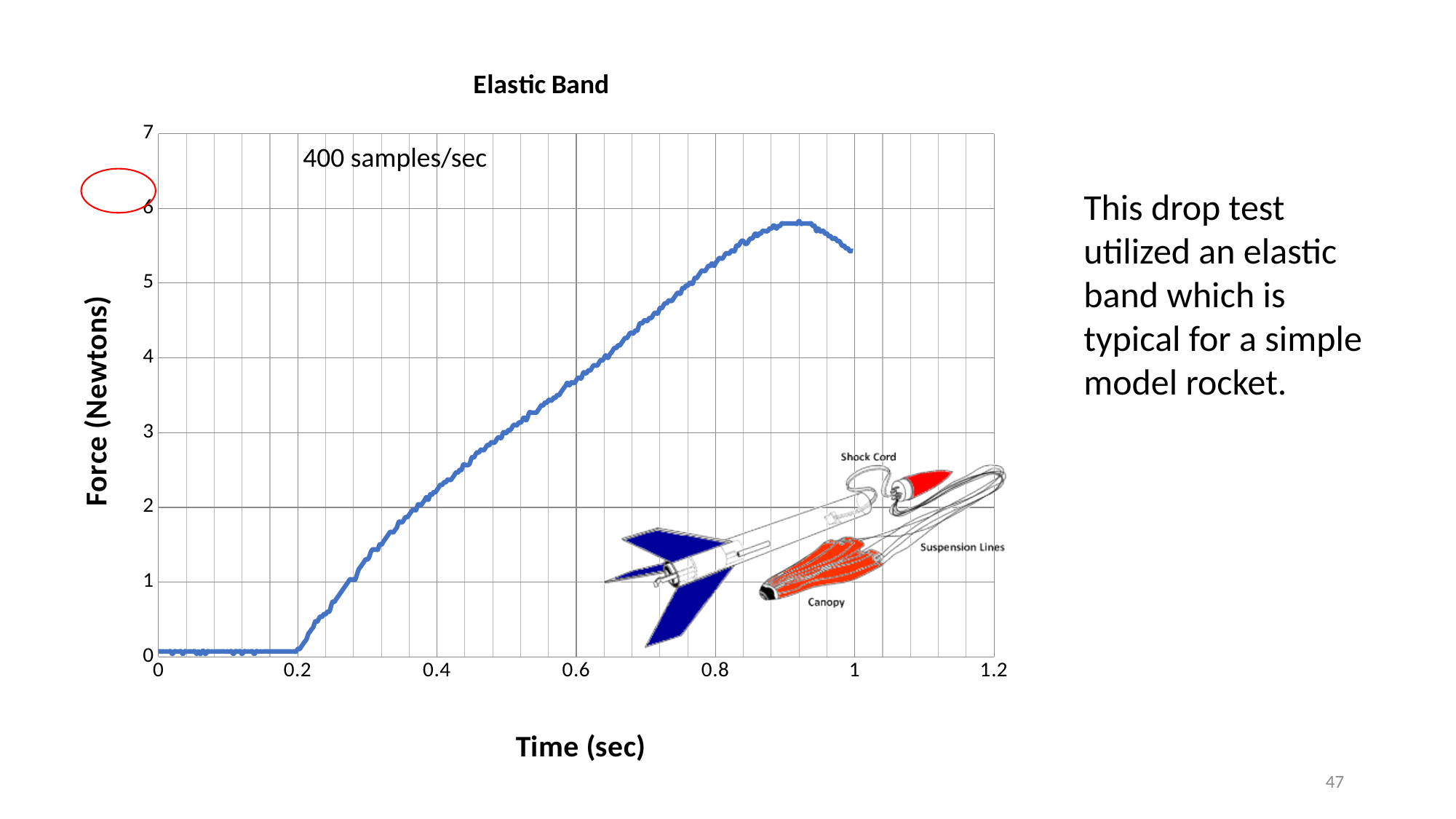
Does the force rise or fall between 0.95 sec and 1 sec? fall Is the force at 0.4 sec greater or less than 3 Newtons? less Is the force at 0.2 sec greater or less than 1 Newton? less What is the title of the chart? Elastic Band Which is larger, the force at 0.4 sec or the force at 0.8 sec? 0.8 sec What is the label of the y axis of the chart? Force (Newtons) Is the force at 0.6 sec greater or less than 3 Newtons? greater What kind of chart is shown on the slide? line chart Does the force rise or fall between 0.2 sec and 0.8 sec? rise